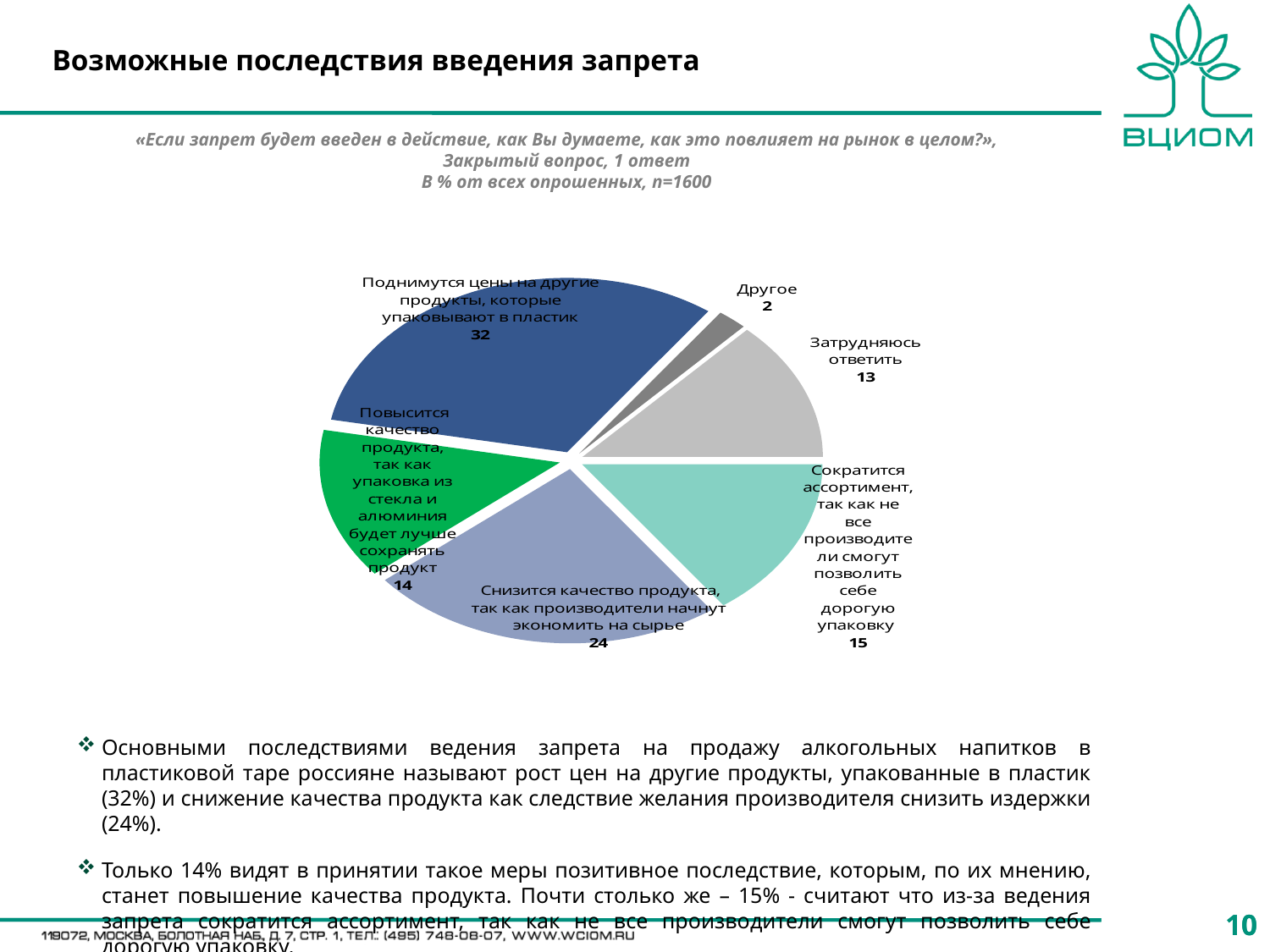
How many slices does the pie chart have? 6 What is the value for «Другое»? 2 What is the difference between the values for «Поднимутся цены на другие продукты» (32) and «Снизится качество продукта» (24)? 8 Which category has the smallest slice of the pie? Другое What is the value for «Снизится качество продукта, так как производители начнут экономить на сырье»? 24 What is the sum of the values for «Затрудняюсь ответить» and «Другое»? 15 What is the value for «Затрудняюсь ответить»? 13 What is the value for «Поднимутся цены на другие продукты, которые упаковывают в пластик»? 32 Which category has the largest slice of the pie? Поднимутся цены на другие продукты, которые упаковывают в пластик What is the sample size (n) stated in the chart subtitle? n=1600 What type of chart is shown on the slide? pie chart Which is larger: the value for «Сократится ассортимент» or the value for «Повысится качество продукта»? Сократится ассортимент